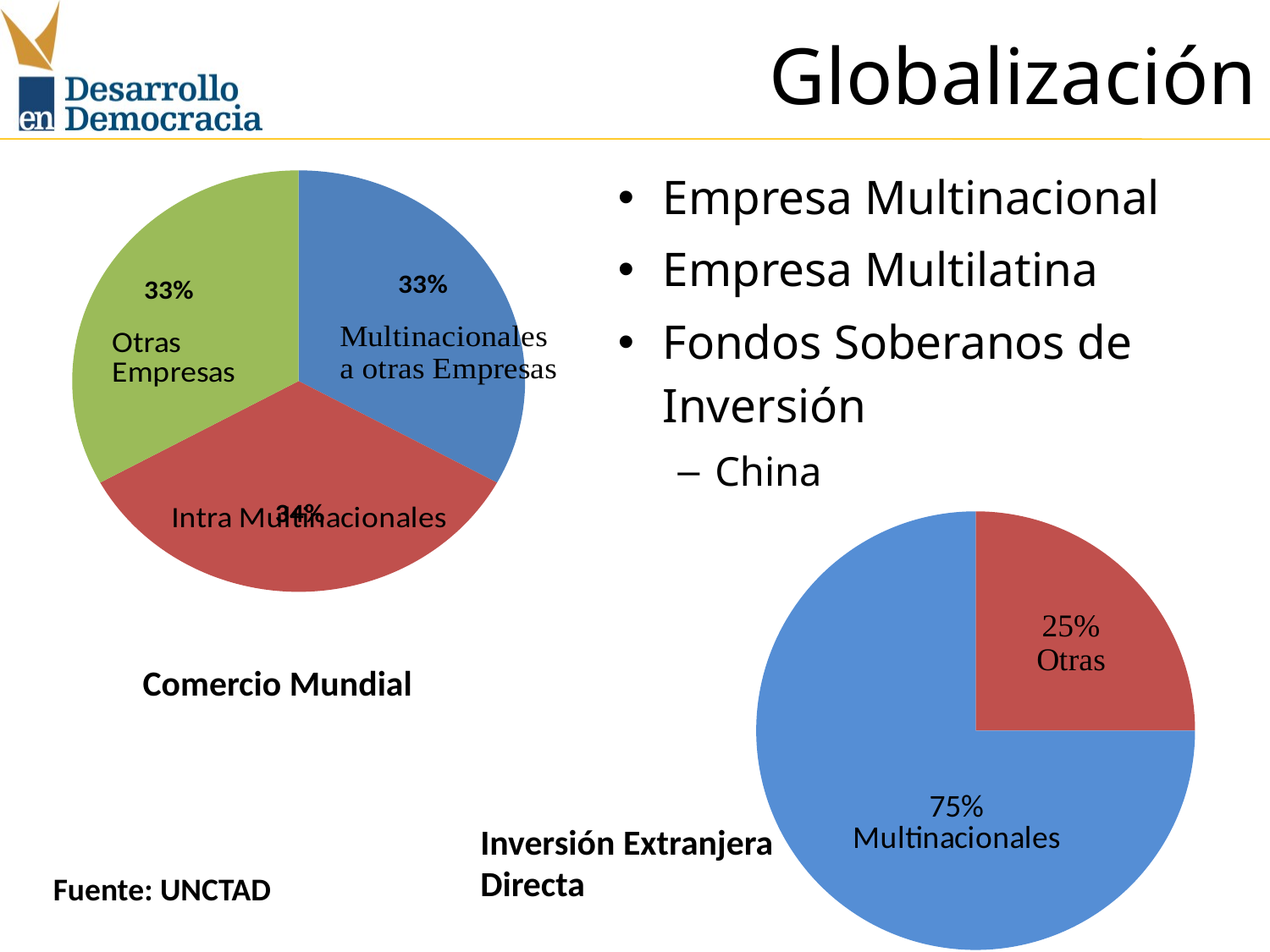
What kind of chart is the "Comercio Mundial" chart? pie chart In the "Inversión Extranjera Directa" chart, what is the difference in percentage points between Multinacionales and Otras? 50 In the "Inversión Extranjera Directa" chart, what share is labelled for Multinacionales? 75% In the "Comercio Mundial" chart, what share is labelled for Otras Empresas? 33% In the "Inversión Extranjera Directa" chart, which slice is the smallest? Otras In the "Inversión Extranjera Directa" chart, which slice is the largest? Multinacionales In the "Inversión Extranjera Directa" chart, what share is labelled for Otras? 25% How many slices does the "Inversión Extranjera Directa" pie chart have? 2 How many slices does the "Comercio Mundial" pie chart have? 3 In the "Comercio Mundial" chart, what share is labelled for Multinacionales a otras Empresas? 33% In the "Inversión Extranjera Directa" chart, what colour is the Otras slice? red What kind of chart is the "Inversión Extranjera Directa" chart? pie chart